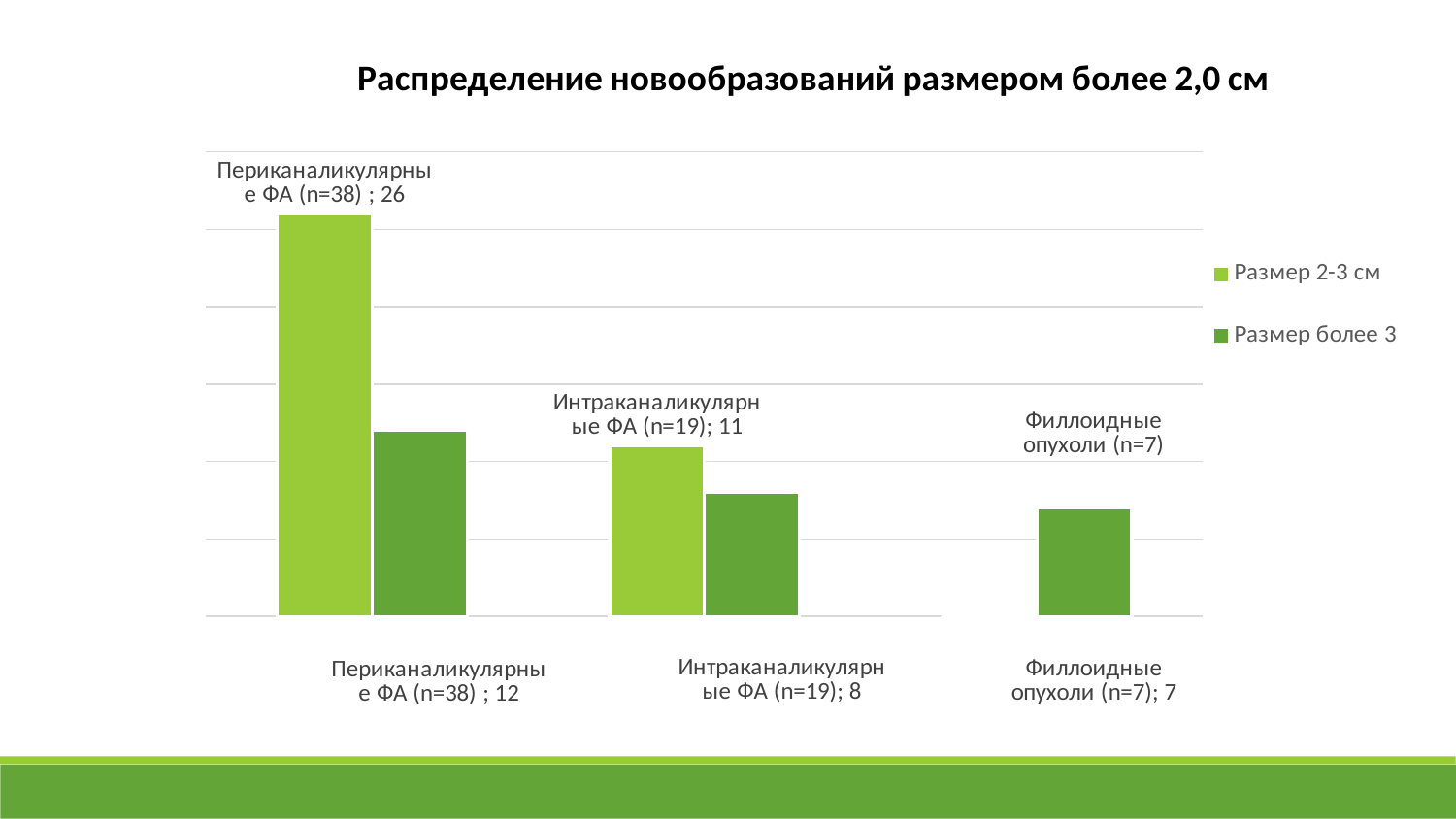
What is the title of the chart? Распределение новообразований размером более 2,0 см Which category has the highest value in the series Размер 2-3 см? Периканаликулярные ФА (n=38) What is the difference between the Размер 2-3 см and Размер более 3 values for Периканаликулярные ФА (n=38)? 14 What is the value for Интраканаликулярные ФА (n=19) in the series Размер 2-3 см? 11 For Интраканаликулярные ФА (n=19), which series has the larger value: Размер 2-3 см or Размер более 3? Размер 2-3 см What is the value for Периканаликулярные ФА (n=38) in the series Размер более 3? 12 How many categories are shown on the x axis? 3 How many series does the legend list? 2 What is the value for Филлоидные опухоли (n=7) in the series Размер более 3? 7 What is the value for Периканаликулярные ФА (n=38) in the series Размер 2-3 см? 26 Which category has the lowest value in the series Размер более 3? Филлоидные опухоли (n=7) What kind of chart is shown on the slide? Bar chart